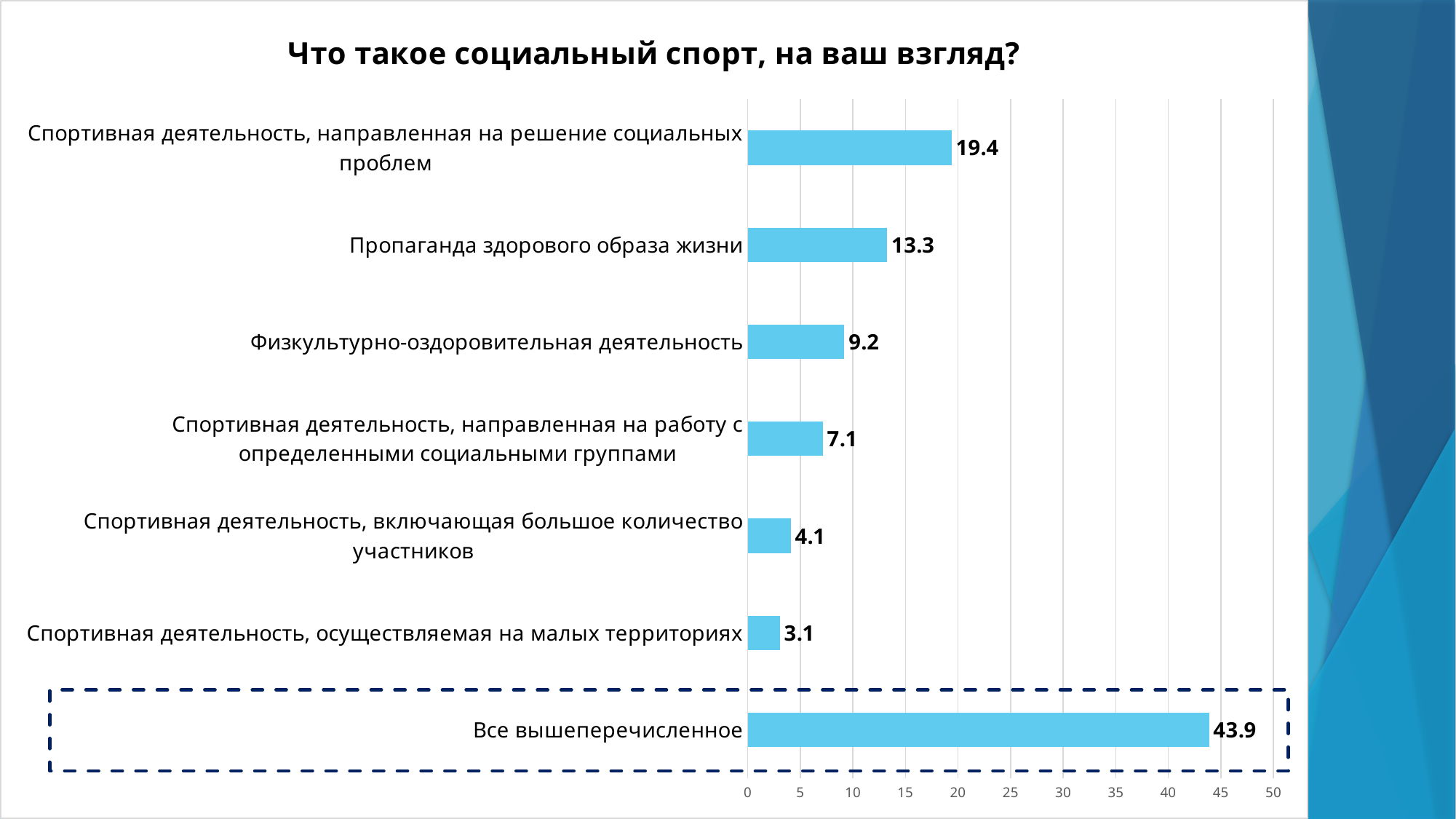
What is the difference between the values for "Спортивная деятельность, направленная на решение социальных проблем" and "Пропаганда здорового образа жизни"? 6.1 Which category has the lowest value? Спортивная деятельность, осуществляемая на малых территориях What is the title of the chart? Что такое социальный спорт, на ваш взгляд? What is the value for "Физкультурно-оздоровительная деятельность"? 9.2 What kind of chart is shown on the slide? bar chart How many categories are shown in the chart? 7 What is the value for "Все вышеперечисленное"? 43.9 Which is larger: the value for "Физкультурно-оздоровительная деятельность" or the value for "Спортивная деятельность, включающая большое количество участников"? Физкультурно-оздоровительная деятельность Which category is enclosed in a dashed outline? Все вышеперечисленное Which category has the highest value? Все вышеперечисленное Is the value for "Все вышеперечисленное" greater or less than 40? greater What is the value for "Пропаганда здорового образа жизни"? 13.3